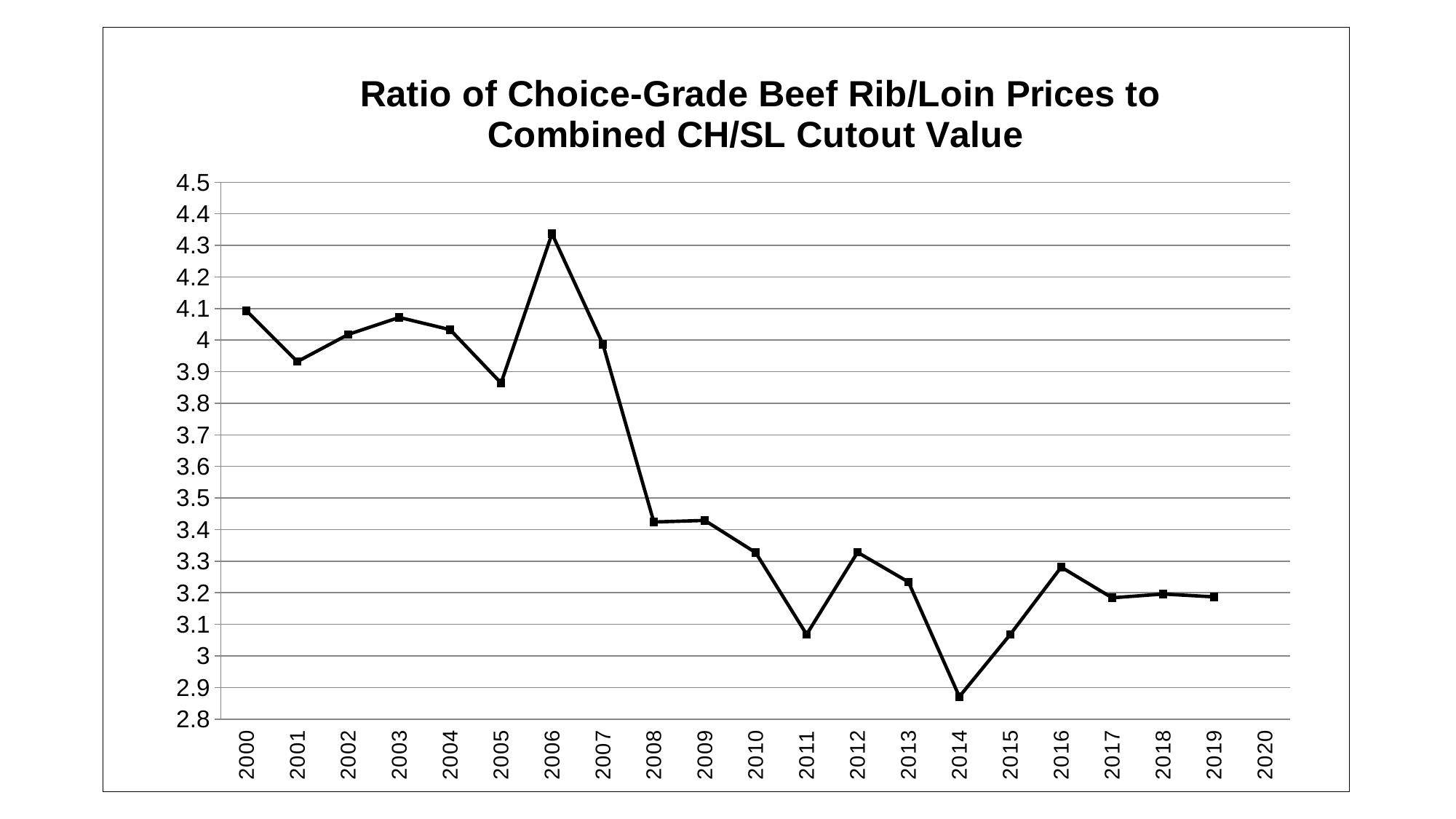
Is the value for 2014 greater or less than 2.9? less Is the value for 2000 greater or less than 4? greater Is the value for 2008 greater or less than 3.5? less What kind of chart is shown on the slide? line chart How many years have a plotted data point on the chart? 20 Which year has the lowest ratio? 2014 Which year has the larger ratio, 2000 or 2019? 2000 What is the title of the chart? Ratio of Choice-Grade Beef Rib/Loin Prices to Combined CH/SL Cutout Value Overall, does the ratio rise or fall from 2000 to 2019? fall Which year has the highest ratio? 2006 Which year has the larger ratio, 2011 or 2012? 2012